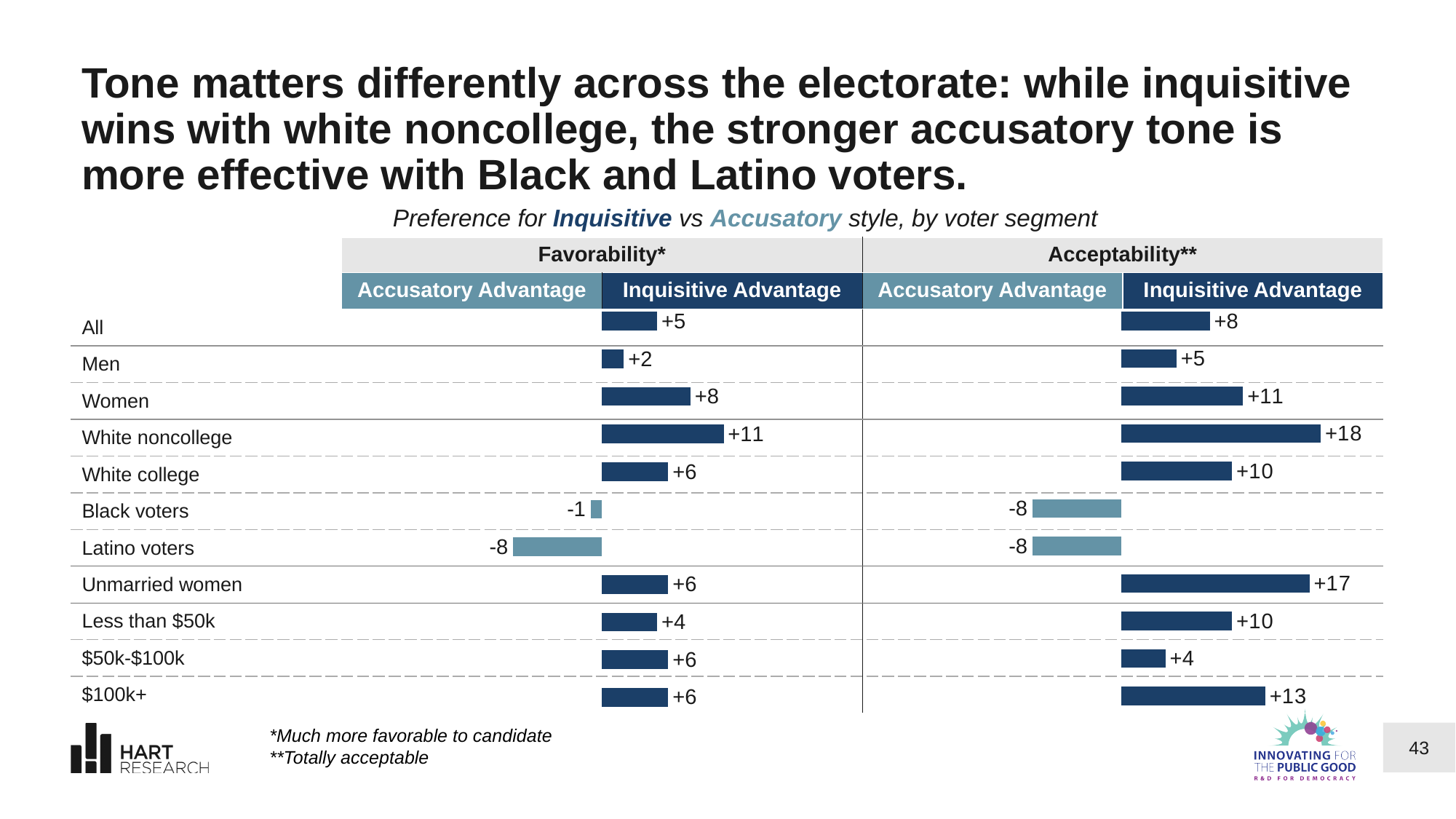
In the Acceptability chart, what is the value for Unmarried women? +17 In the Acceptability chart, which voter segment has the highest value? White noncollege In the Favorability chart, what is the value for White noncollege? +11 In the Acceptability chart, what is the value for Black voters? -8 How many voter segments are shown in the Favorability chart? 11 In the Acceptability chart, what is the difference between the values for White noncollege and $50k-$100k? 14 In the Favorability chart, which is larger, the value for Women or the value for Men? Women In the Favorability chart, what is the difference between the values for All and Men? 3 In the Favorability chart, what is the value for Latino voters? -8 What colour are the bars showing an Accusatory Advantage? Light blue What kind of chart is used to show the Acceptability data? Bar chart In the Favorability chart, which voter segment has the lowest value? Latino voters